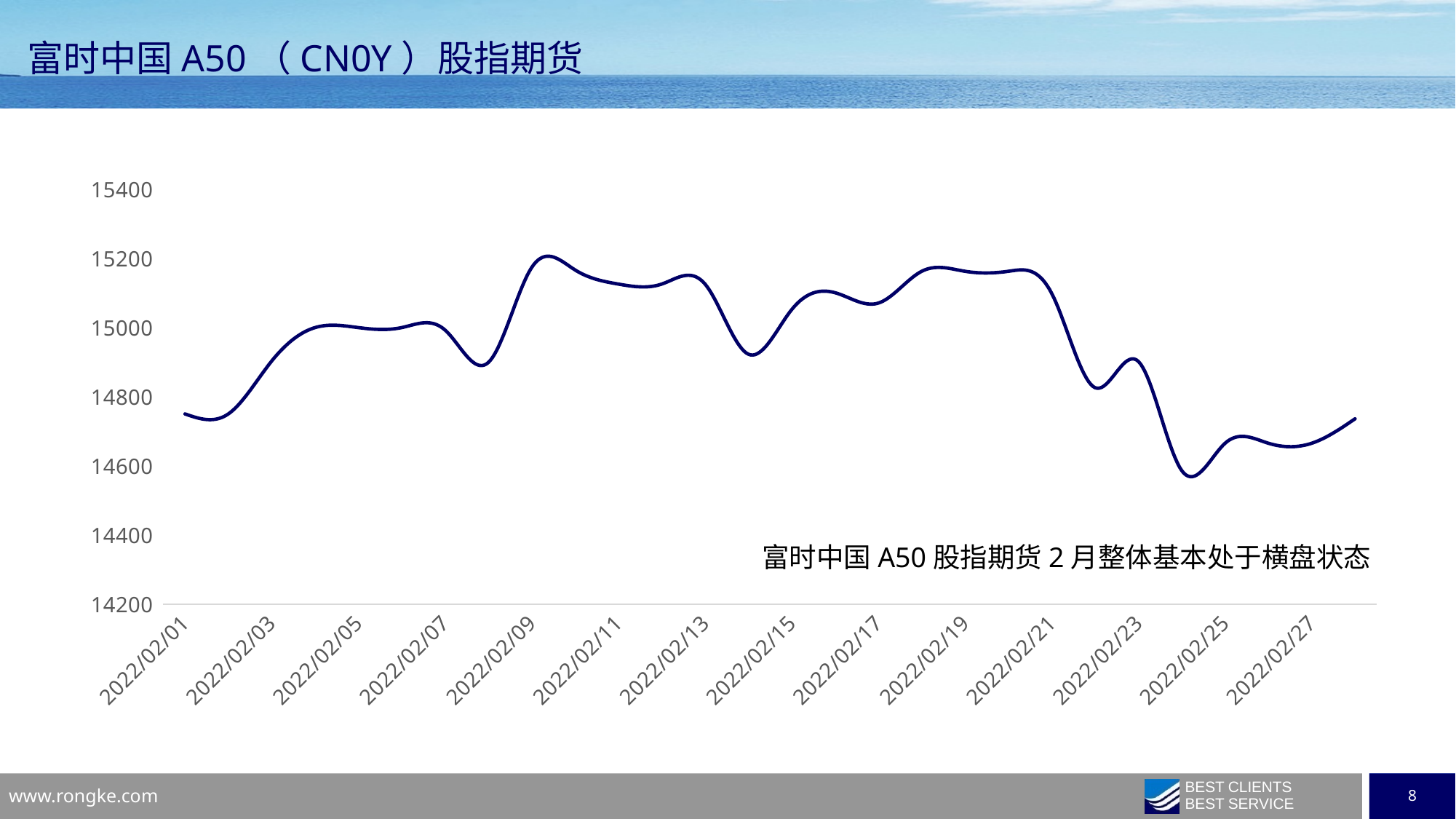
What is the highest value shown on the vertical axis? 15400 What kind of chart is shown on the slide? line chart Is the value on 2022/02/09 greater or less than 15000? greater Is the value on 2022/02/01 greater or less than 14800? less Which date has the larger value, 2022/02/09 or 2022/02/01? 2022/02/09 Which date has the larger value, 2022/02/19 or 2022/02/25? 2022/02/19 Is the value on 2022/02/03 greater or less than 14800? greater Does the line rise or fall between 2022/02/19 and 2022/02/25? fall What is the title of the slide? 富时中国A50（CN0Y）股指期货 How many date labels are shown on the horizontal axis? 14